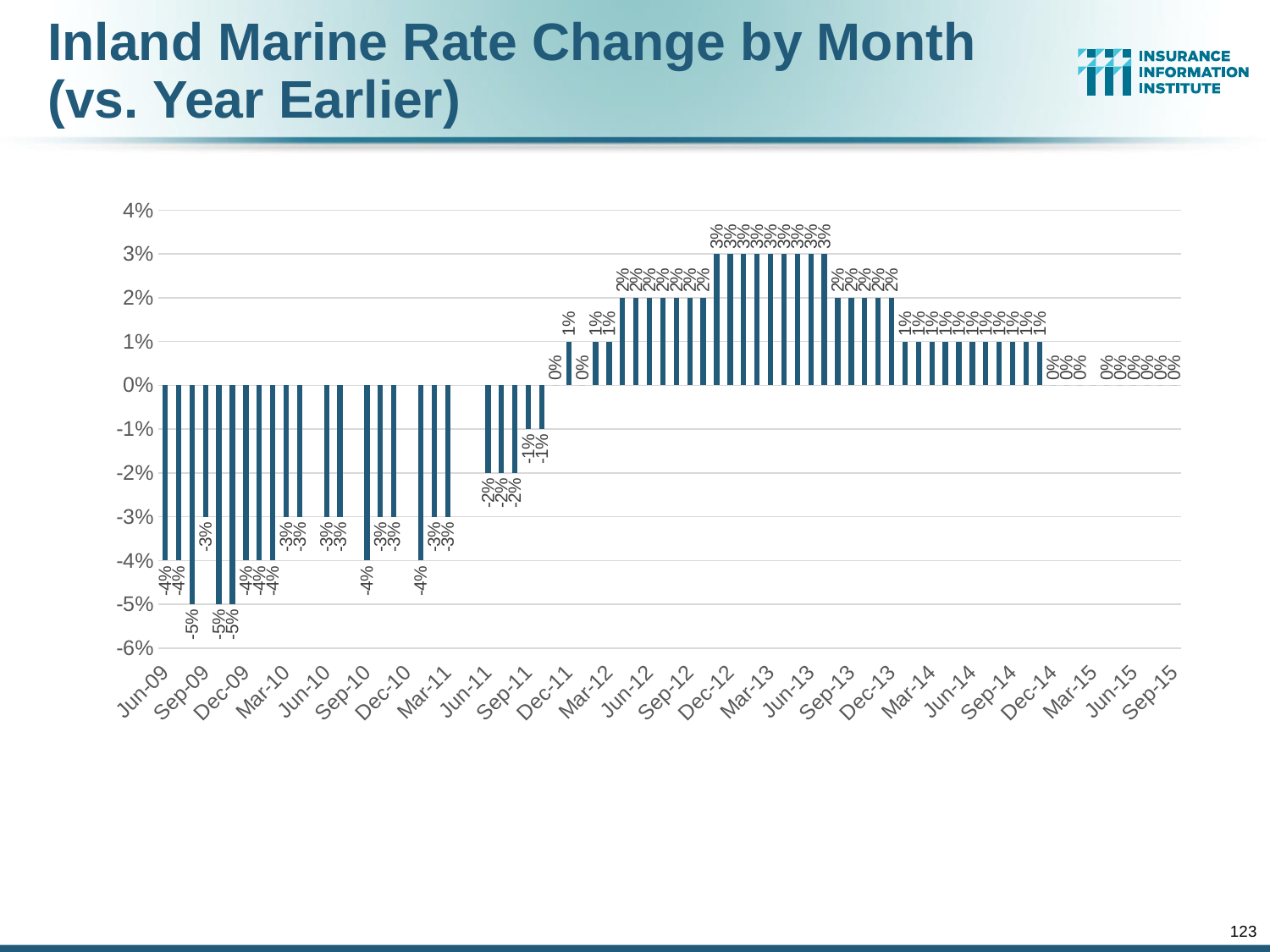
What is the highest rate change value shown in the chart? 3% Do the rate changes generally rise or fall from Jun-09 to Mar-13? rise What is the lowest rate change value shown in the chart? -5% What is the difference between the highest value (3%) and the lowest value (-5%) in the chart? 8 percentage points Which is larger, the rate change for Jun-09 or for Sep-09? Sep-09 What is the rate change shown for Sep-09? -3% What is the title of the chart? Inland Marine Rate Change by Month (vs. Year Earlier) What kind of chart is shown on the slide? bar chart What is the rate change shown for Jun-09? -4% What is the rate change shown for Mar-13? 3% What is the rate change shown for Sep-15? 0% What is the rate change shown for Sep-14? 1%